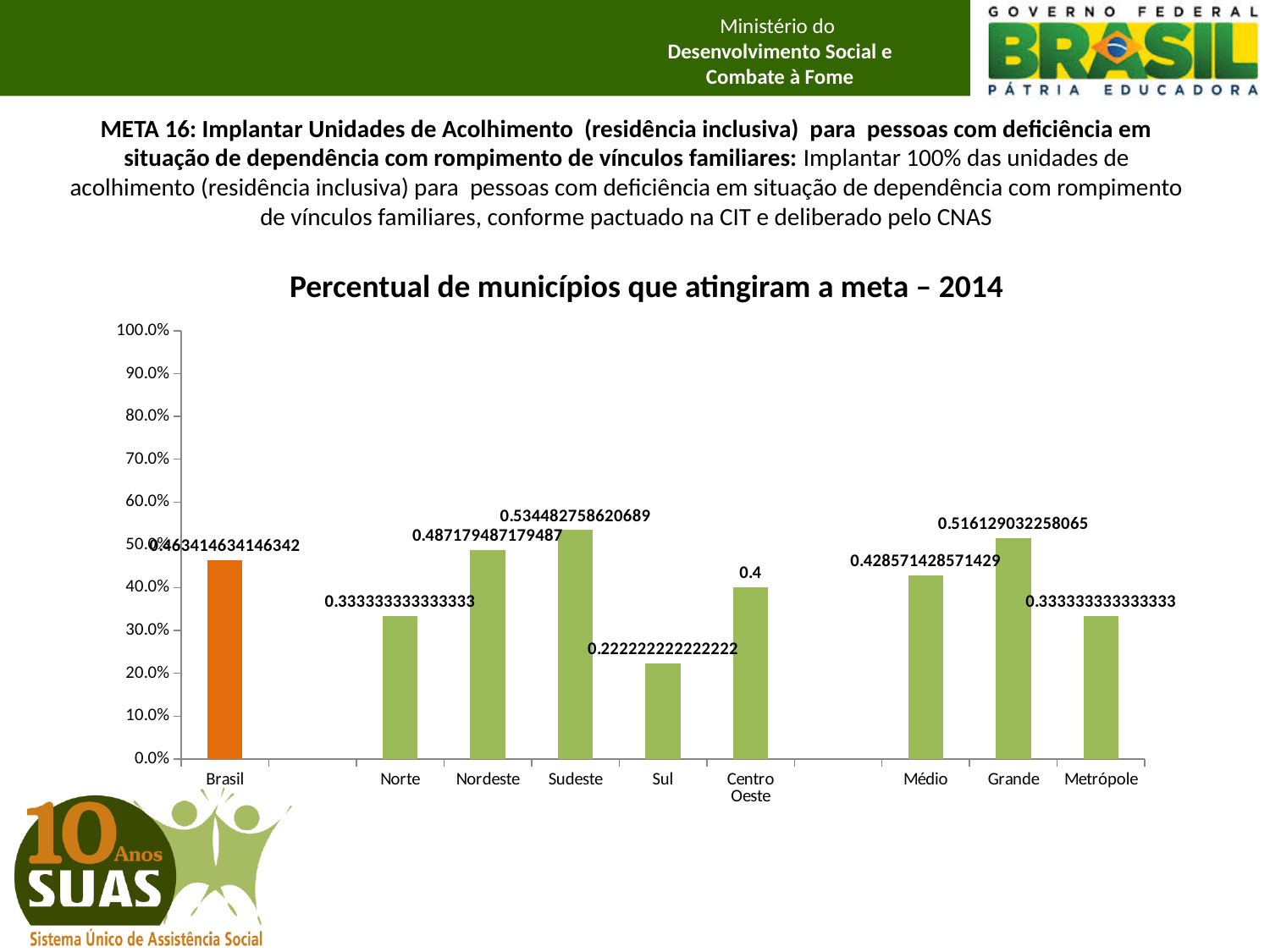
Is the value for Norte greater or less than 40.0%? less What is the title of the chart? Percentual de municípios que atingiram a meta – 2014 What is the value shown for Centro Oeste? 0.4 What is the value shown for Grande? 0.516129032258065 What is the value shown for Sudeste? 0.534482758620689 Which category has the highest bar? Sudeste What is the value shown for Sul? 0.222222222222222 How many labeled categories have bars in the chart? 9 Is the value for Brasil greater or less than 40.0%? greater Which is larger, the value for Grande or the value for Médio? Grande Which category has the lowest bar? Sul What kind of chart is shown on the slide? bar chart